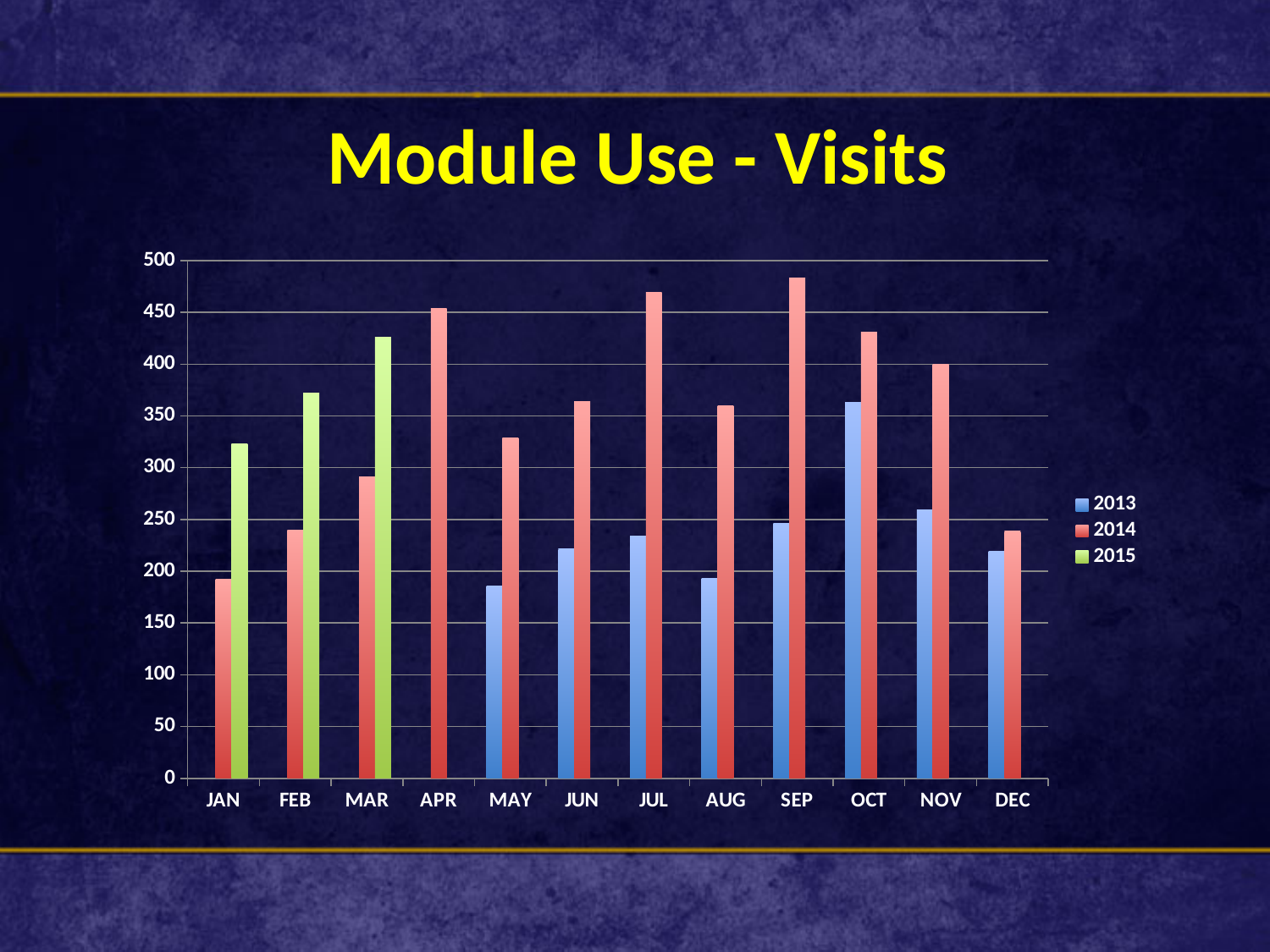
How many months are shown on the x axis? 12 What kind of chart is shown on the slide? bar chart Is the value for 2013 in MAY greater or less than 200? less Is the value for 2015 in MAR greater or less than 400? greater In OCT, which series has the larger value, 2013 or 2014? 2014 Which month has the highest value for the 2013 series? OCT Which month has the highest value for the 2015 series? MAR Do the 2015 values rise or fall from JAN to MAR? rise How many series does the legend list? 3 Is the value for 2014 in SEP greater or less than 450? greater Which month has the highest value for the 2014 series? SEP Which month has the lowest value for the 2014 series? JAN